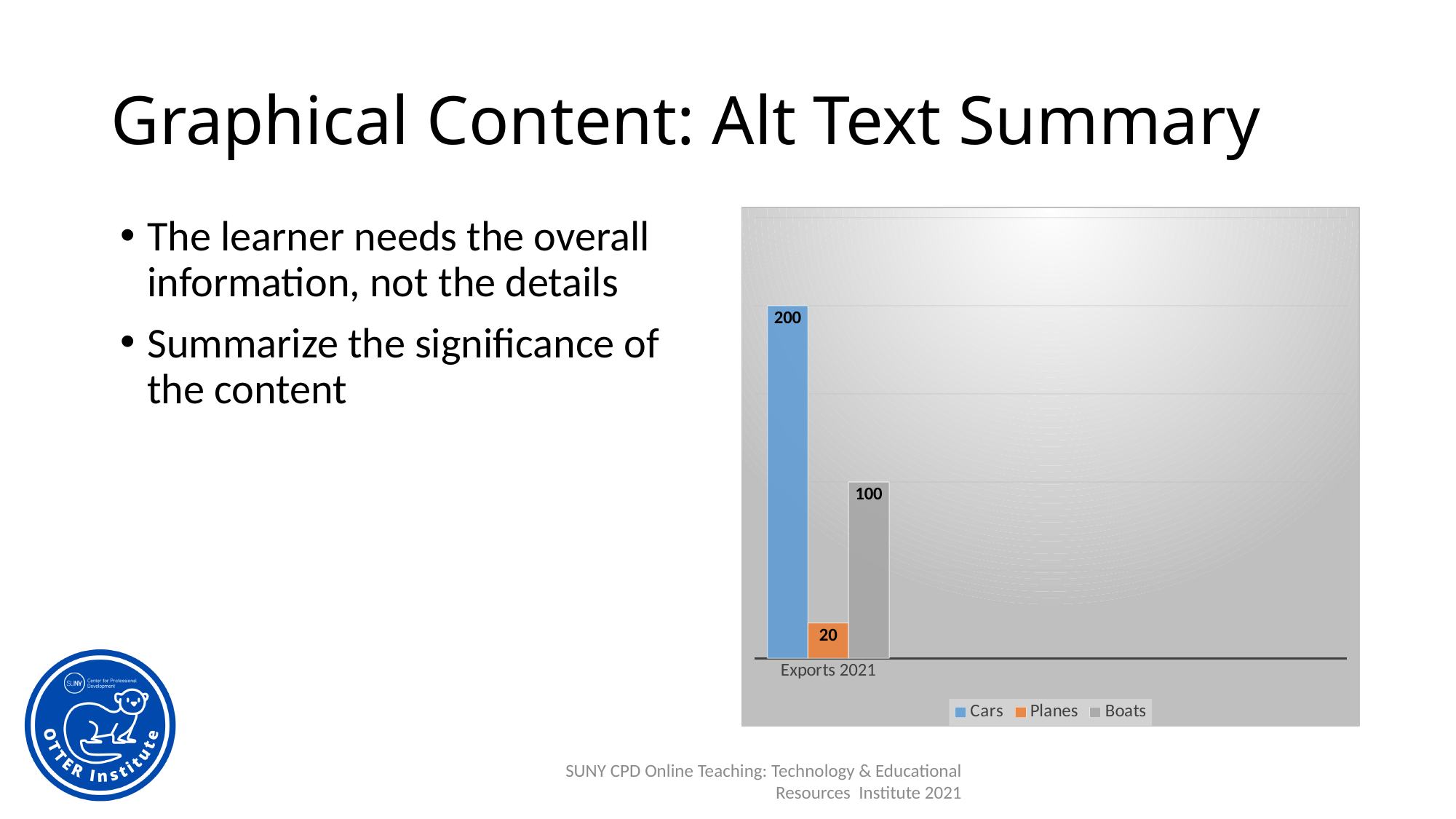
Which series has the lowest value in the chart? Planes How many series does the legend list? 3 Which series has the highest value in the chart? Cars What is the difference between the values for Cars and Boats? 100 What is the value for Cars in the Exports 2021 chart? 200 Which is larger, the value for Planes or the value for Boats? Boats What is the value for Boats in the Exports 2021 chart? 100 What is the category label shown on the x axis of the chart? Exports 2021 What is the value for Planes in the Exports 2021 chart? 20 What is the difference between the values for Boats and Planes? 80 What kind of chart is shown on the slide? Bar chart What colour is the bar for Planes in the chart? Orange